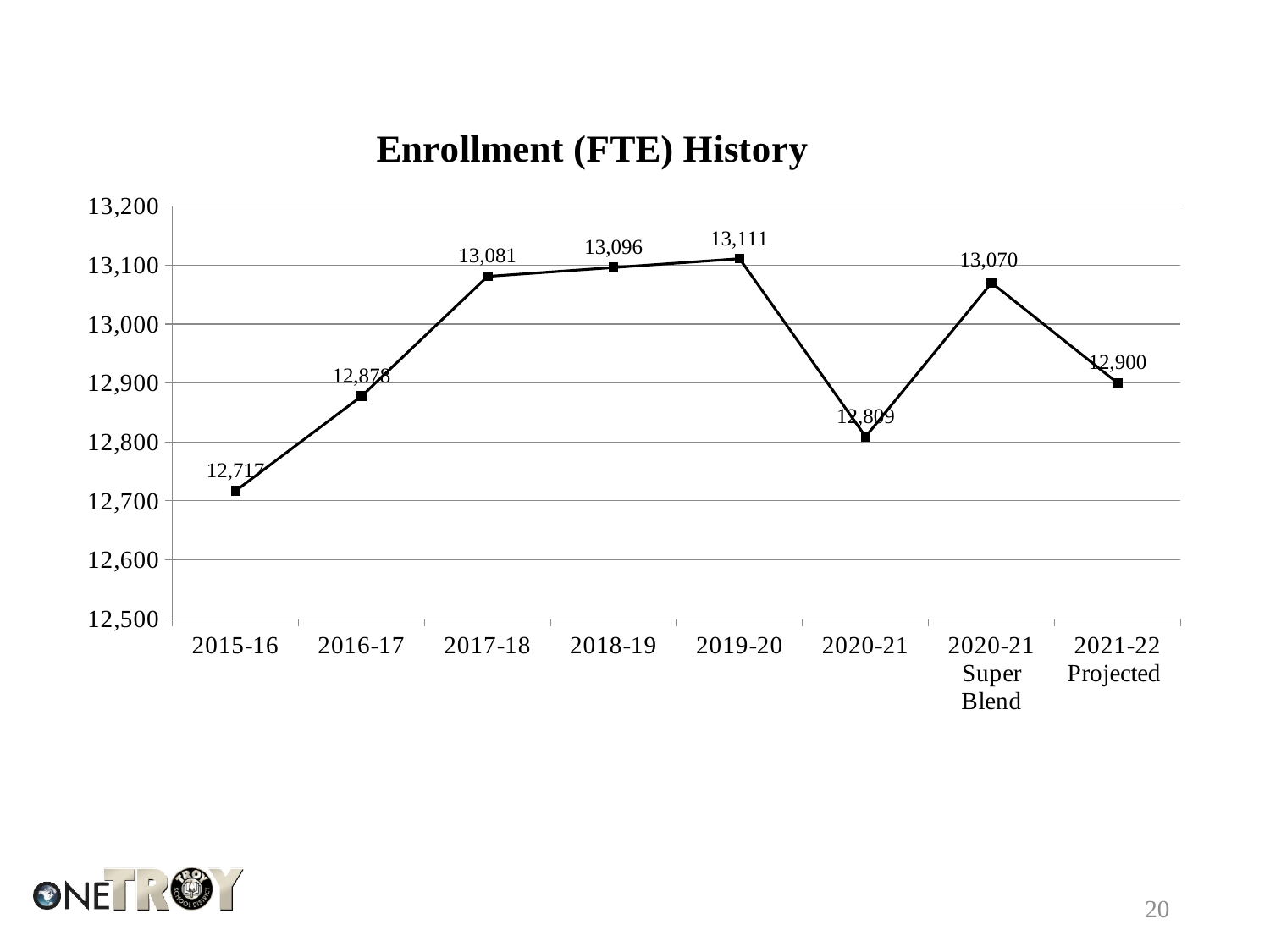
What is the enrollment (FTE) value for 2019-20? 13,111 Which year has the highest enrollment (FTE)? 2019-20 What is the difference in enrollment between 2019-20 and 2020-21? 302 Which is larger, the enrollment for 2017-18 or for 2020-21 Super Blend? 2017-18 What is the enrollment (FTE) value for 2020-21 Super Blend? 13,070 Which year has the lowest enrollment (FTE)? 2015-16 What is the title of the chart? Enrollment (FTE) History What is the enrollment (FTE) value for 2015-16? 12,717 What is the projected enrollment (FTE) for 2021-22? 12,900 Is the enrollment value for 2016-17 greater or less than 12,900? less How many data points are plotted on the chart? 8 What kind of chart is shown on the slide? line chart